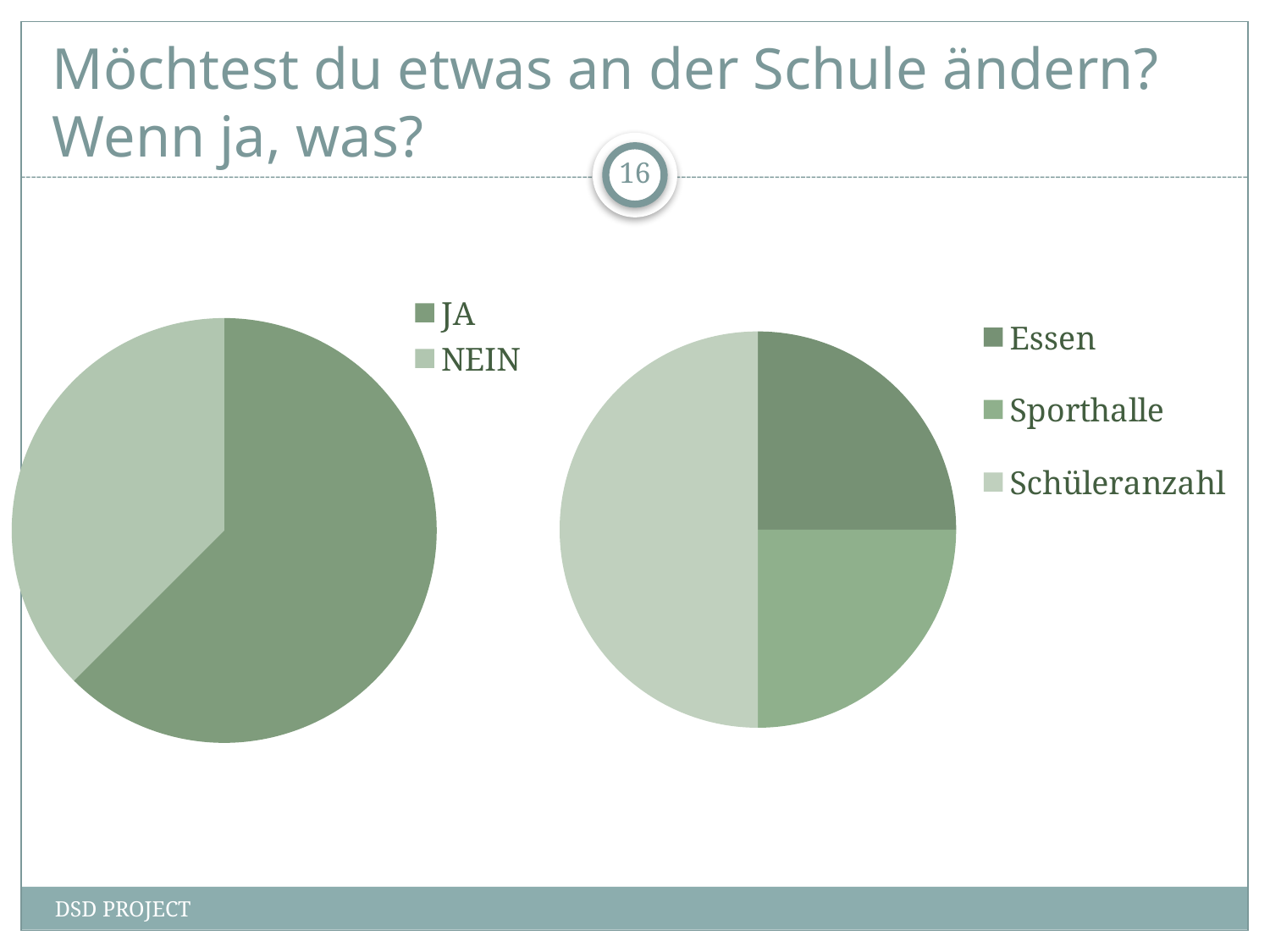
In the left pie chart, which slice is the largest? JA What are the legend entries of the right pie chart? Essen, Sporthalle, Schüleranzahl How many entries does the legend of the left pie chart list? 2 How many slices does the left pie chart have? 2 How many slices does the right pie chart have? 3 In the left pie chart, which is larger, JA or NEIN? JA In the right pie chart, which slice is the largest? Schüleranzahl In the right pie chart, which is larger, Schüleranzahl or Essen? Schüleranzahl What kind of chart is the right chart on the slide? pie chart How many entries does the legend of the right pie chart list? 3 What kind of chart is the left chart on the slide? pie chart In the left pie chart, which slice is the smallest? NEIN